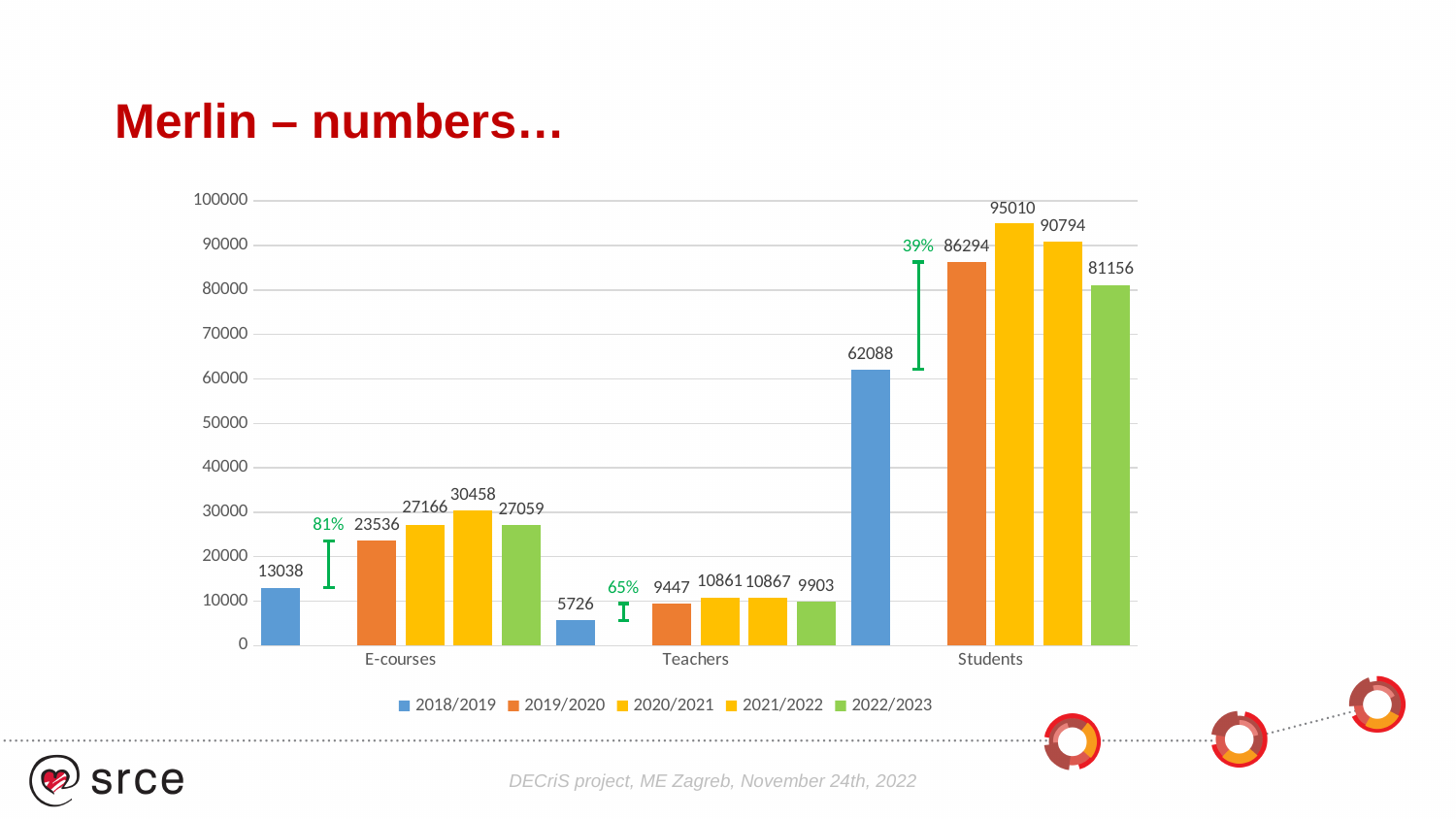
Which category has the highest value in 2022/2023? Students What is the value for E-courses in 2019/2020? 23536 Which category has the lowest value in 2019/2020? Teachers What is the value for Teachers in 2018/2019? 5726 What percentage label is shown next to the Students group? 39% What type of chart is shown on the slide? bar chart What is the difference between the Students values for 2019/2020 and 2018/2019? 24206 What is the value for Teachers in 2022/2023? 9903 Which is larger, the E-courses value for 2022/2023 or for 2019/2020? 2022/2023 How many series does the legend list? 5 What is the value for Students in 2018/2019? 62088 How many categories are shown on the x axis? 3